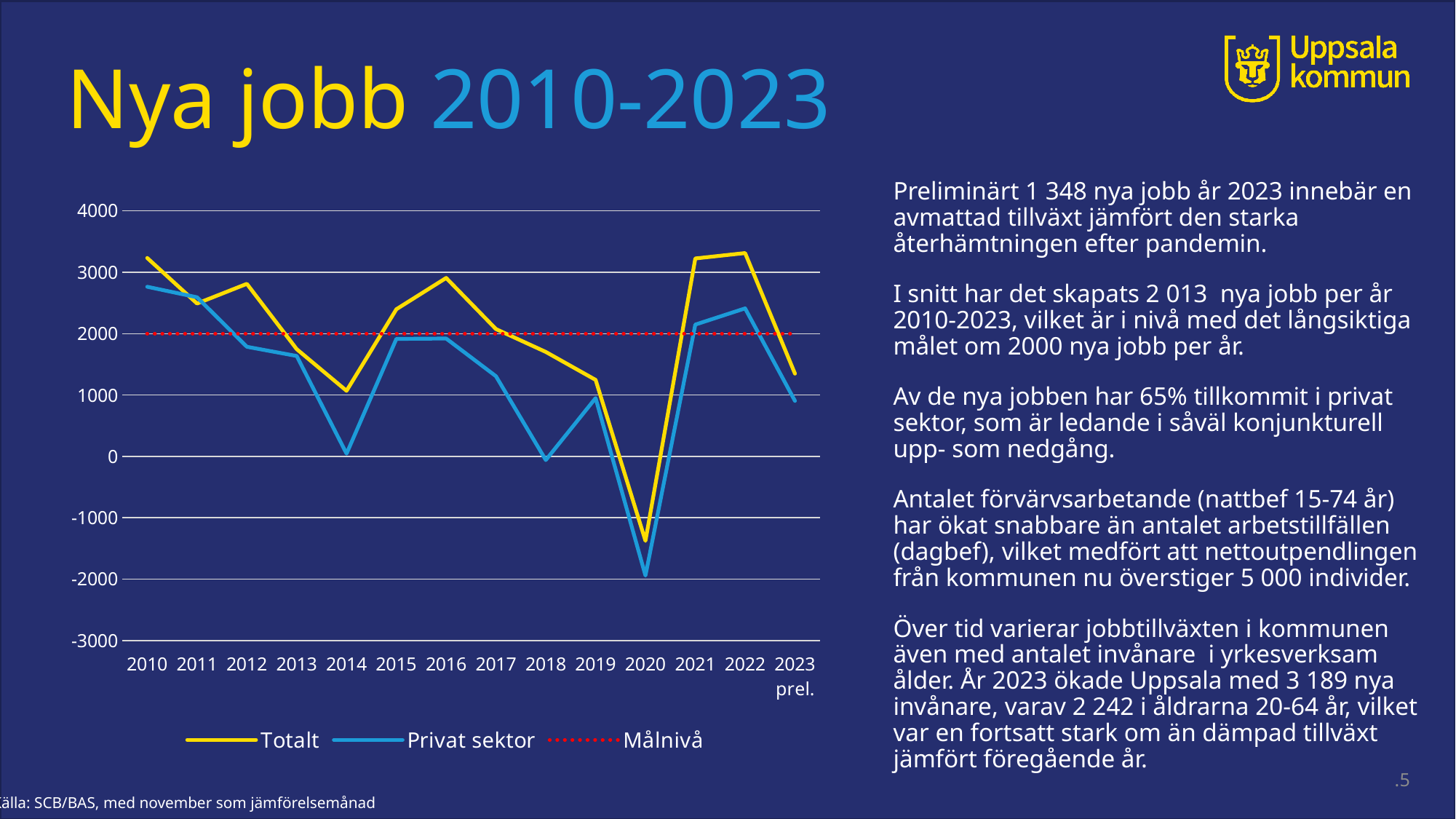
In which year is the Totalt series at its lowest? 2020 Which is larger for Totalt: the value in 2010 or the value in 2014? 2010 What kind of chart is shown on the slide? line chart Is the value for Totalt in 2020 greater or less than -1000? less Is the value for Privat sektor in 2020 greater or less than -1000? less How many years are plotted along the x axis of the chart? 14 Is the value for Totalt in 2022 greater or less than 3000? greater At what value does the Målnivå line sit on the chart? 2000 How many series does the chart legend list? 3 Does the Totalt series rise or fall from 2016 to 2020? fall In which year is the Privat sektor series at its highest? 2010